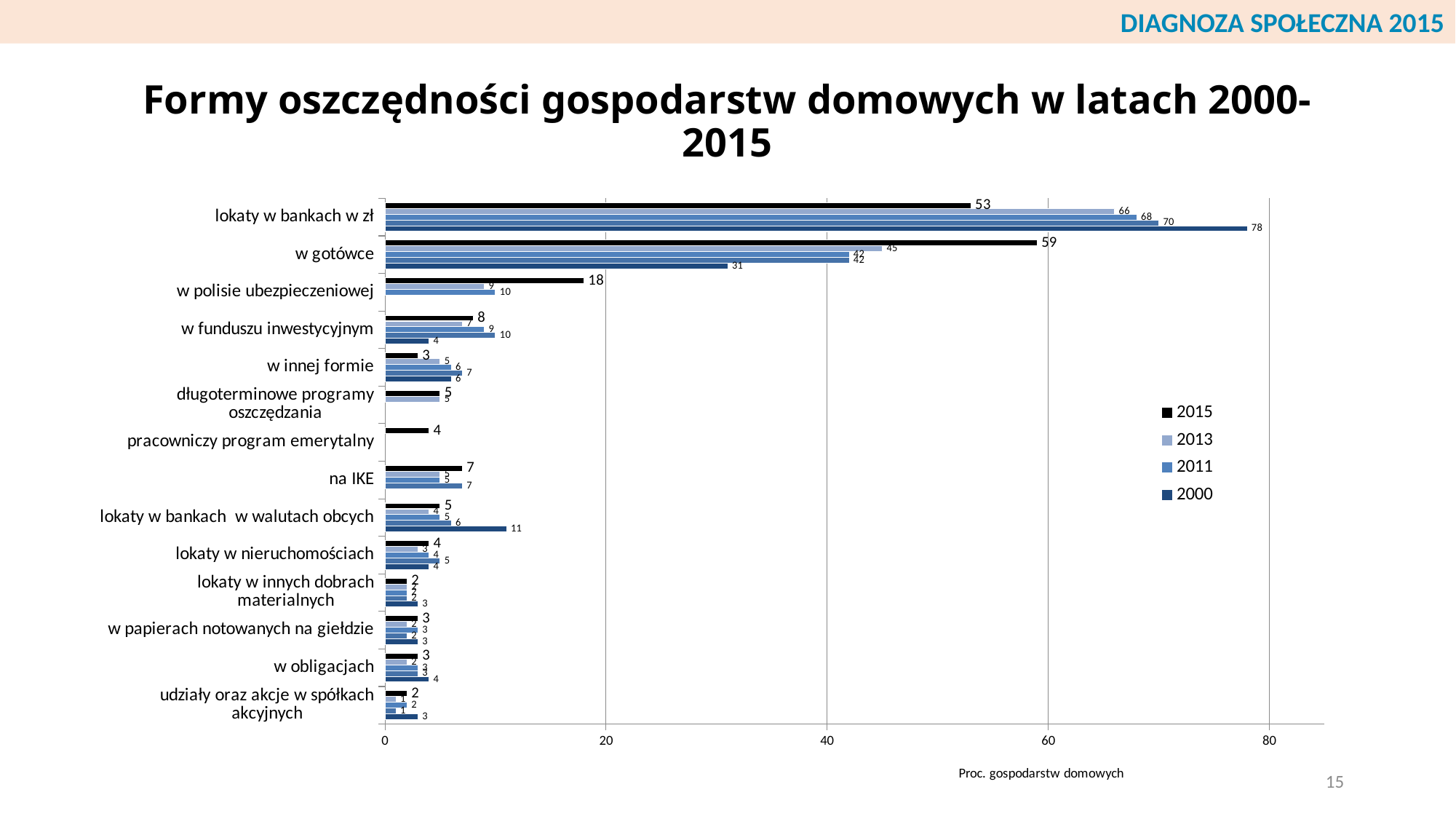
What is the difference between the 2015 values for 'w gotówce' and 'lokaty w bankach w zł'? 6 Is the 2015 value for 'w gotówce' greater or less than 40? greater How many categories are listed on the vertical axis of the chart? 14 What is the 2015 value for 'pracowniczy program emerytalny'? 4 How many series does the legend list? 4 What is the 2015 value for 'w polisie ubezpieczeniowej'? 18 What is the label of the horizontal axis? Proc. gospodarstw domowych What is the 2015 value for 'lokaty w bankach w zł'? 53 Which has the larger 2015 value: 'w polisie ubezpieczeniowej' or 'w funduszu inwestycyjnym'? w polisie ubezpieczeniowej What kind of chart is shown on the slide? bar chart Which category has the highest 2015 value? w gotówce What is the 2015 value for 'w gotówce'? 59